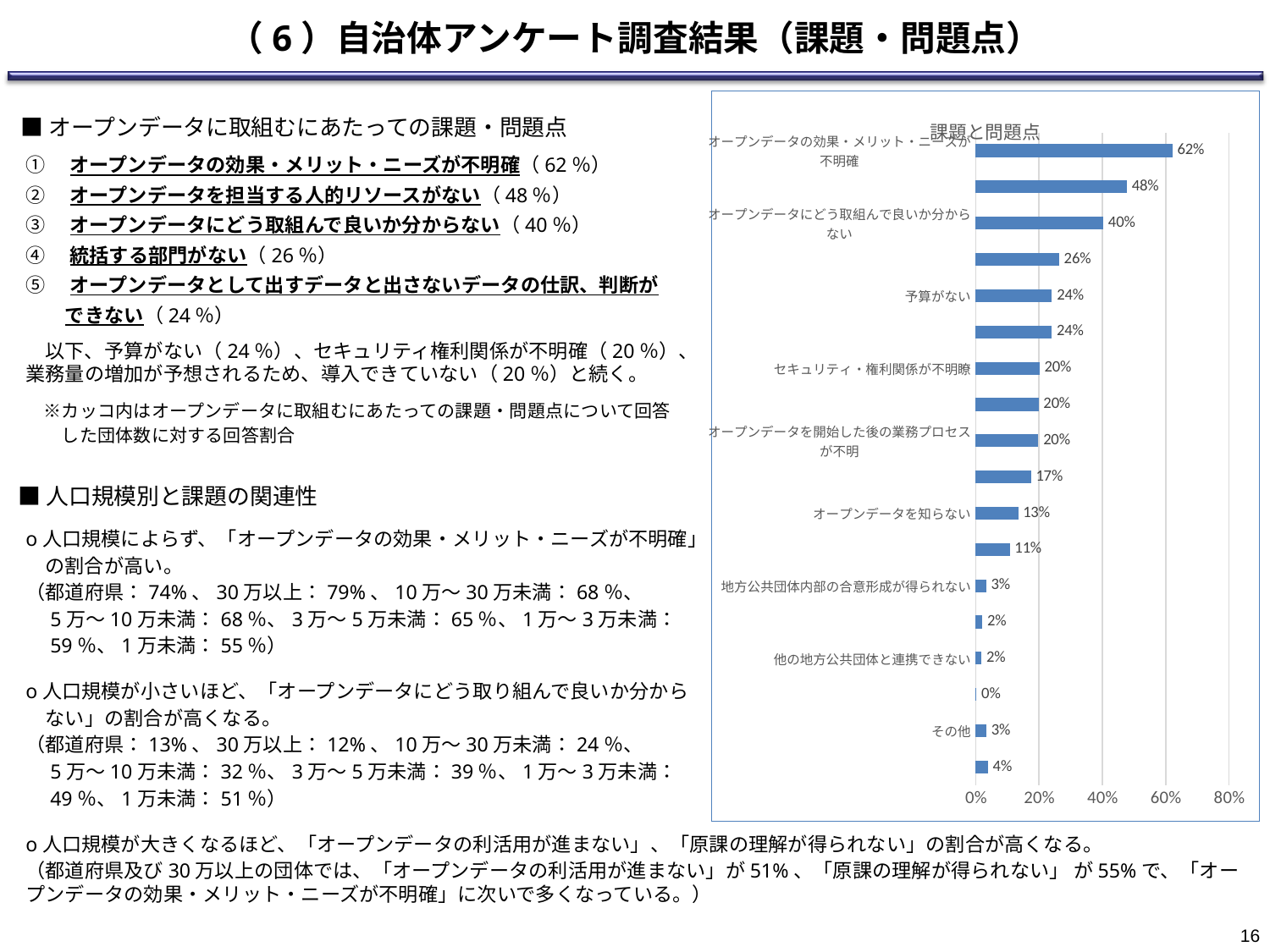
How many bars are plotted in the chart? 18 What is the lowest value shown in the chart? 0% What is the value for オープンデータにどう取組んで良いか分からない? 40% What is the value for 他の地方公共団体と連携できない? 2% What is the value for オープンデータの効果・メリット・ニーズが不明確? 62% Which category has the highest value in the chart? オープンデータの効果・メリット・ニーズが不明確 What is the title of the chart? 課題と問題点 What type of chart is shown on the slide? bar chart What is the value for 予算がない? 24% What is the difference between the values for オープンデータの効果・メリット・ニーズが不明確 and オープンデータにどう取組んで良いか分からない? 22% Which is larger, the value for 予算がない or the value for セキュリティ・権利関係が不明瞭? 予算がない What is the value for オープンデータを知らない? 13%